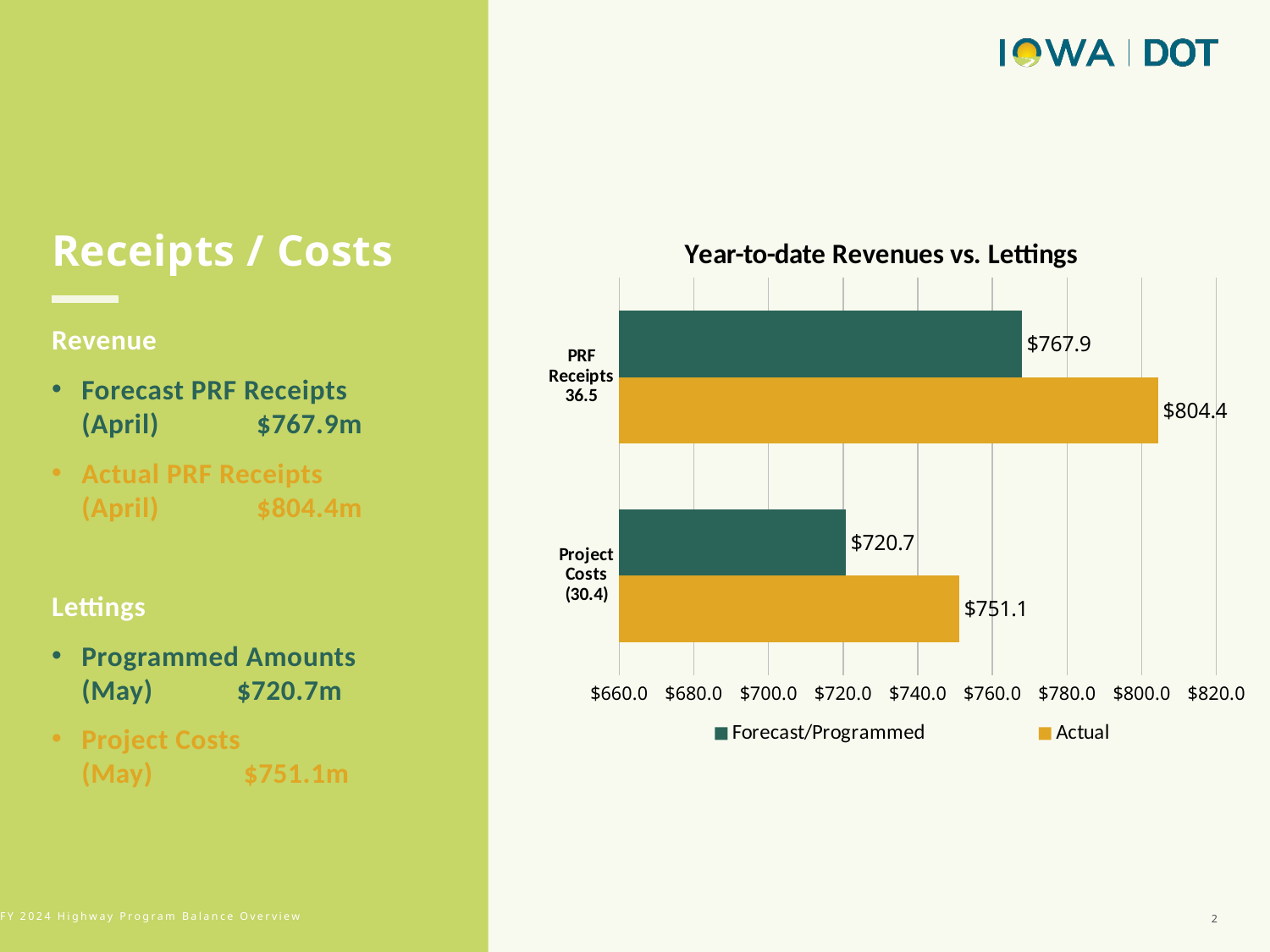
Which is larger for Project Costs, the Forecast/Programmed value or the Actual value? Actual What is the Forecast/Programmed value for Project Costs? $720.7 Which bar in the chart has the lowest value? Forecast/Programmed Project Costs Which bar in the chart has the highest value? Actual PRF Receipts What is the Forecast/Programmed value for PRF Receipts? $767.9 What is the Actual value for Project Costs? $751.1 What kind of chart is shown on the slide? Bar chart How many series does the legend list? 2 What is the title of the chart? Year-to-date Revenues vs. Lettings What is the difference between the Actual and Forecast/Programmed values for Project Costs? $30.4 What is the difference between the Actual and Forecast/Programmed values for PRF Receipts? $36.5 What is the Actual value for PRF Receipts? $804.4